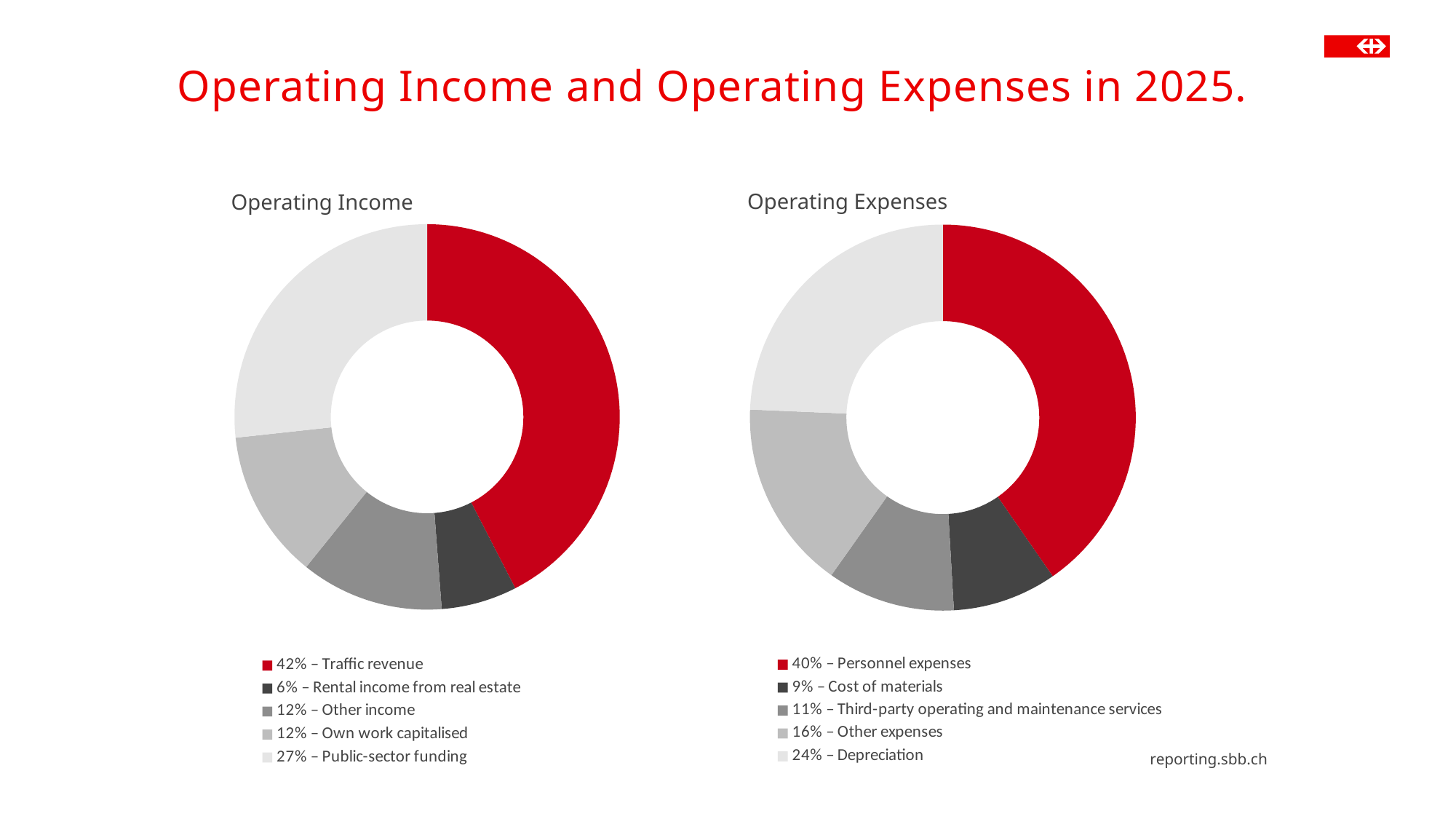
In the Operating Expenses chart, what share does Personnel expenses have? 40% In the Operating Income chart, what share does Traffic revenue have? 42% What kind of chart is the Operating Expenses chart? Doughnut chart In the Operating Expenses chart, which category has the largest share? Personnel expenses In the Operating Income chart, what is the difference between the shares of Traffic revenue and Public-sector funding? 15% In the Operating Expenses chart, which is larger: Other expenses or Third-party operating and maintenance services? Other expenses In the Operating Expenses chart, which category has the smallest share? Cost of materials In the Operating Income chart, what share does Public-sector funding have? 27% How many categories does the Operating Income chart show? 5 In the Operating Expenses chart, what share does Depreciation have? 24% In the Operating Income chart, which category has the smallest share? Rental income from real estate In the Operating Expenses chart, what colour is the Personnel expenses slice? Red